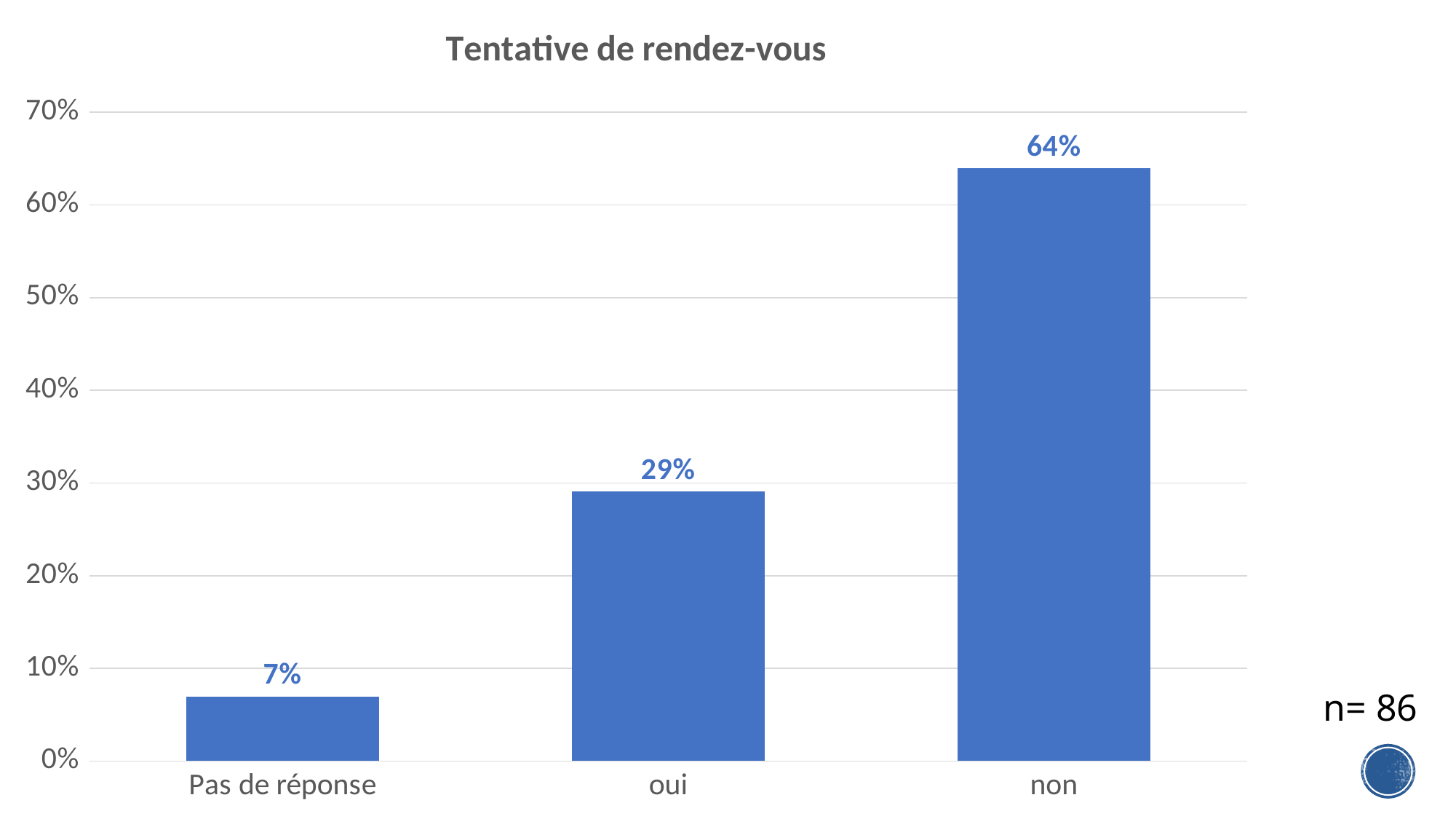
What is the title of the chart? Tentative de rendez-vous What is the difference between the values for "oui" and "Pas de réponse"? 22% How many categories are shown on the x axis? 3 What kind of chart is shown? bar chart Which is larger, the value for "oui" or the value for "Pas de réponse"? oui What is the difference between the values for "non" and "oui"? 35% Which category has the highest value? non What is the value for "non"? 64% What is the value for "Pas de réponse"? 7% Which category has the lowest value? Pas de réponse Is the value for "non" greater or less than 60%? greater What is the value for "oui"? 29%